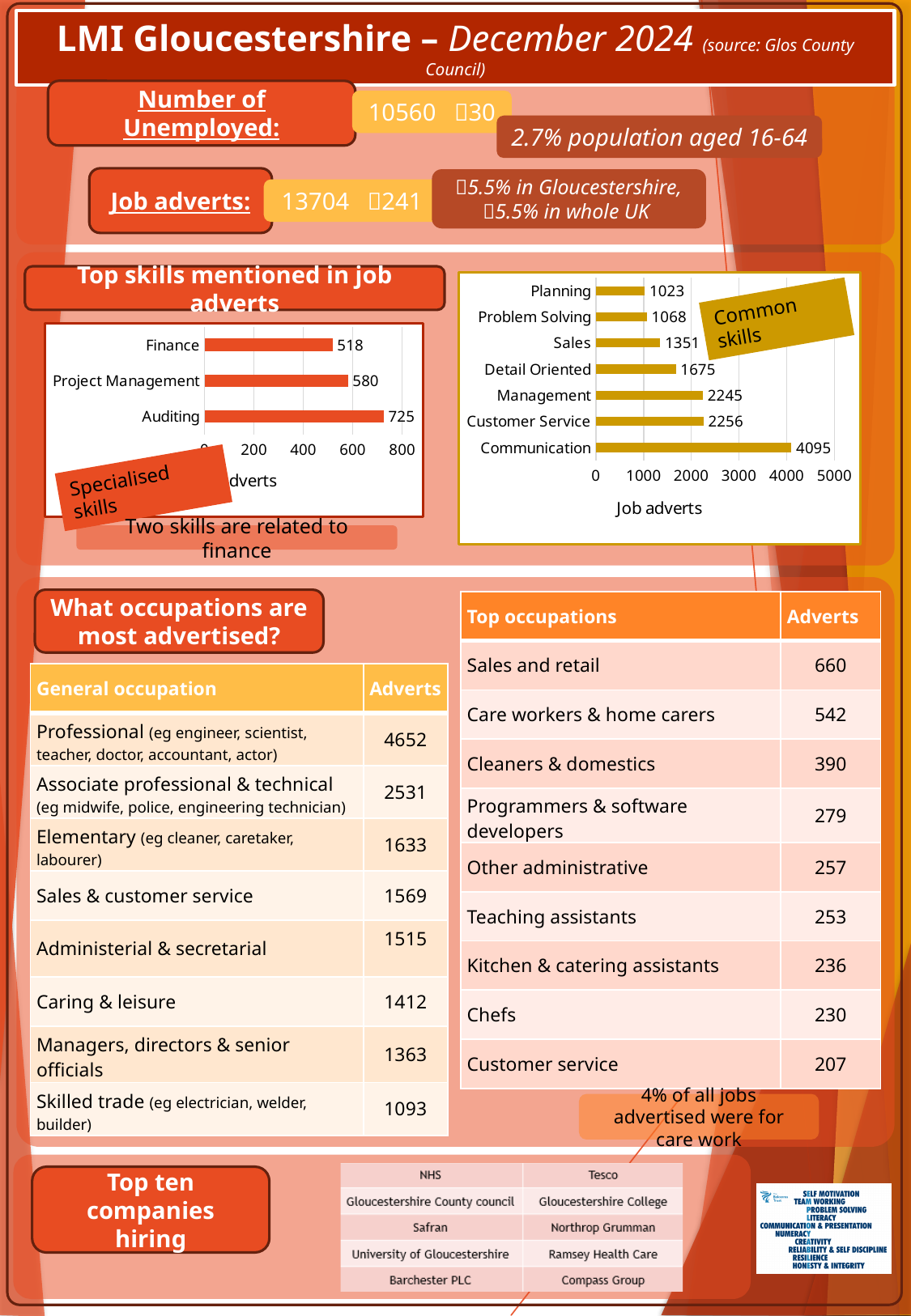
How many skills are plotted in the Specialised skills chart on the left? 3 In the Common skills chart on the right, what is the difference in job adverts between Communication and Customer Service? 1839 In the Specialised skills chart on the left, what is the difference in job adverts between Auditing and Finance? 207 In the Common skills chart on the right, which skill has the most job adverts? Communication In the Common skills chart on the right, how many job adverts mention Communication? 4095 In the Specialised skills chart on the left, which skill has the fewest job adverts? Finance In the Specialised skills chart on the left, how many job adverts mention Auditing? 725 In the Common skills chart on the right, how many job adverts mention Detail Oriented? 1675 In the Specialised skills chart on the left, how many job adverts mention Project Management? 580 In the Common skills chart on the right, which skill has the fewest job adverts? Planning What type of chart is the Common skills chart on the right? Bar chart In the Common skills chart on the right, which has more job adverts: Sales or Management? Management